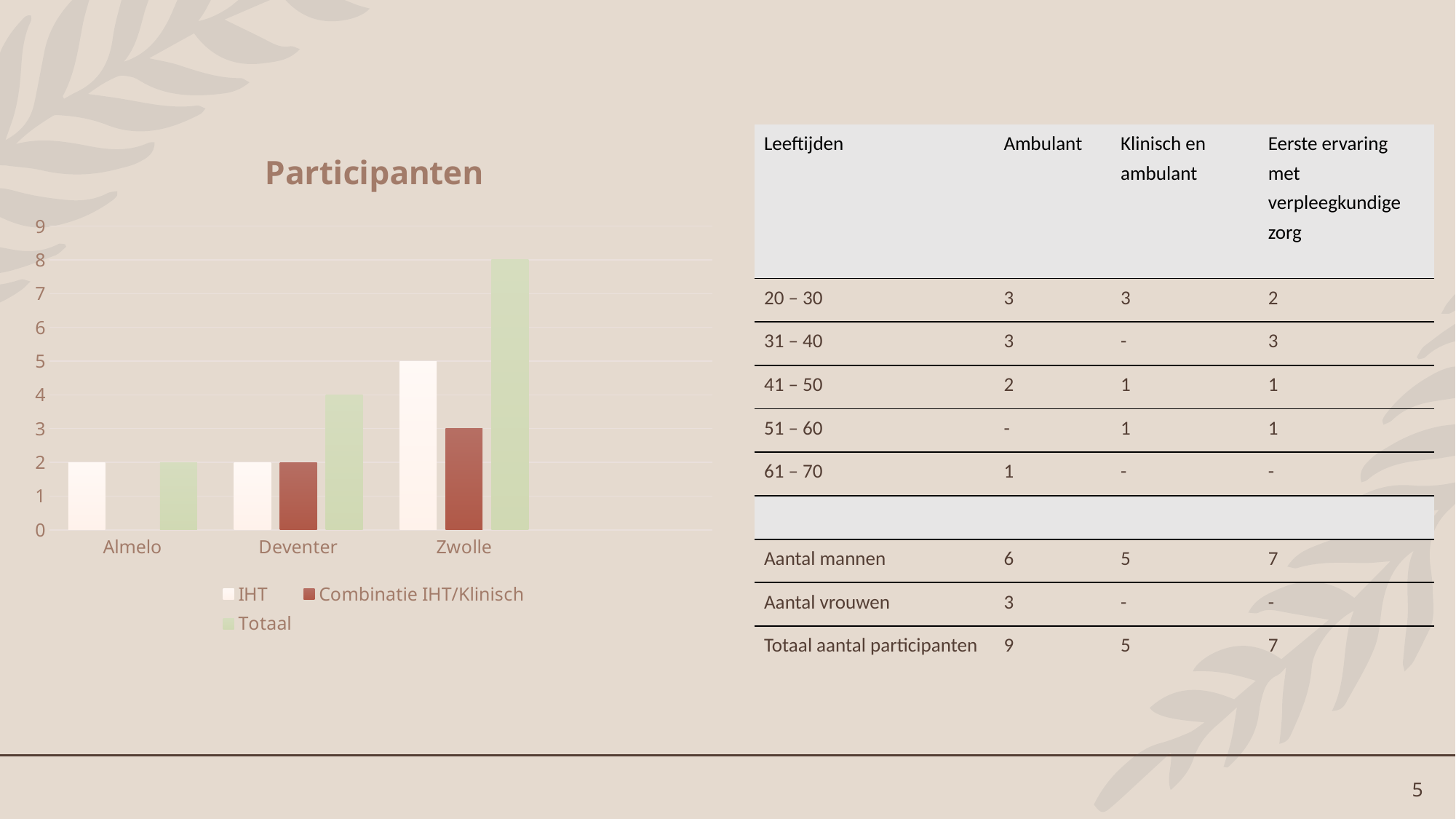
Is the Totaal value for Zwolle greater or less than 6? greater What is the IHT value for Zwolle? 5 What is the Totaal value for Deventer? 4 What kind of chart is shown on the slide? bar chart How many categories are shown on the x axis of the chart? 3 What is the Combinatie IHT/Klinisch value for Deventer? 2 What is the difference between the Totaal values for Zwolle and Deventer? 4 What is the title of the chart? Participanten Which category has the lowest Totaal value? Almelo Which category has the highest Totaal value? Zwolle How many series does the chart legend list? 3 What is the Totaal value for Zwolle? 8